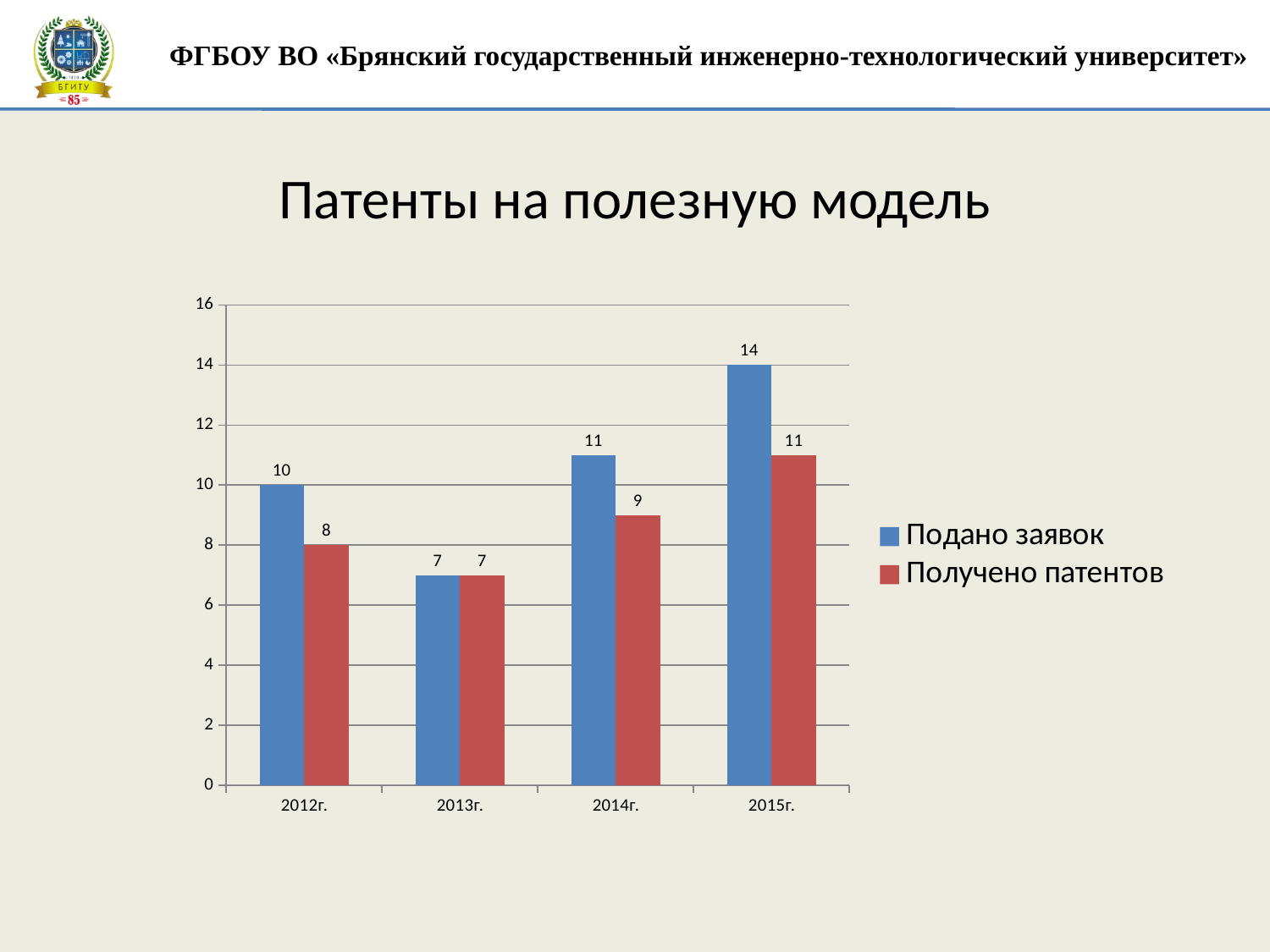
What is the value of Получено патентов for 2012г.? 8 How many series does the legend list? 2 In which year is Подано заявок highest? 2015г. What kind of chart is shown on the slide? bar chart How many years are shown on the x axis? 4 What is the value of Получено патентов for 2014г.? 9 In which year is Получено патентов lowest? 2013г. Is the value of Подано заявок for 2015г. greater or less than 12? greater Which is larger in 2014г.: Подано заявок or Получено патентов? Подано заявок What is the difference between Подано заявок and Получено патентов in 2015г.? 3 What is the title of the chart? Патенты на полезную модель What is the value of Подано заявок for 2015г.? 14